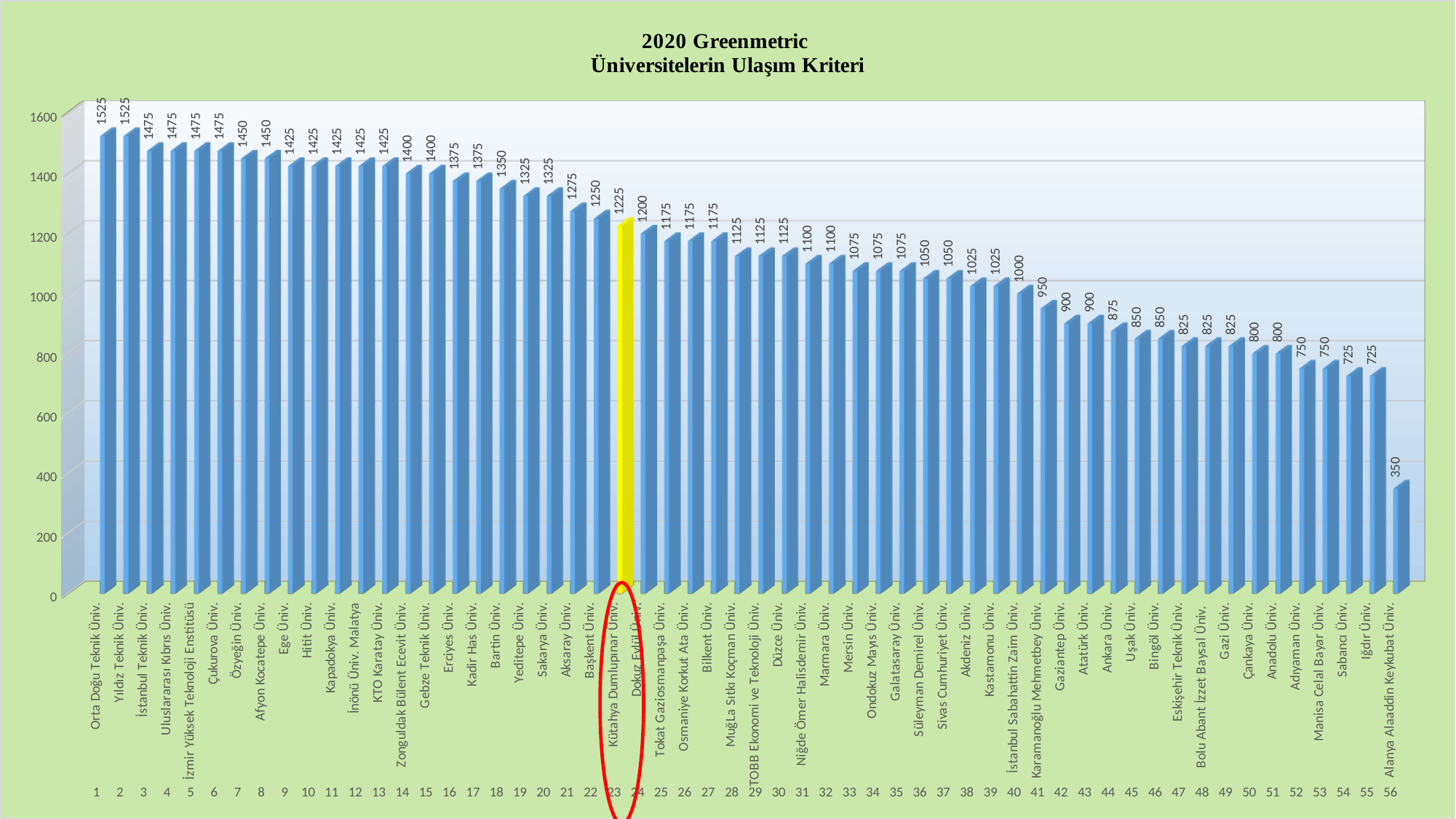
Which bar is highlighted in yellow on the chart? Kütahya Dumlupınar Üniv. What is the difference between the values for Kütahya Dumlupınar Üniv. and Dokuz Eylül Üniv.? 25 What is the value for Kütahya Dumlupınar Üniv.? 1225 What is the value for Bilkent Üniv.? 1175 Which has a larger value, Marmara Üniv. or Gazi Üniv.? Marmara Üniv. Is the value for Karamanoğlu Mehmetbey Üniv. greater or less than 1000? less Which university has the lowest value on the chart? Alanya Alaaddin Keykubat Üniv. What is the difference between the values for Orta Doğu Teknik Üniv. and Alanya Alaaddin Keykubat Üniv.? 1175 What type of chart is shown on the slide? bar chart How many universities are shown on the chart? 56 What is the highest value shown on the chart? 1525 What is the value for Ankara Üniv.? 875